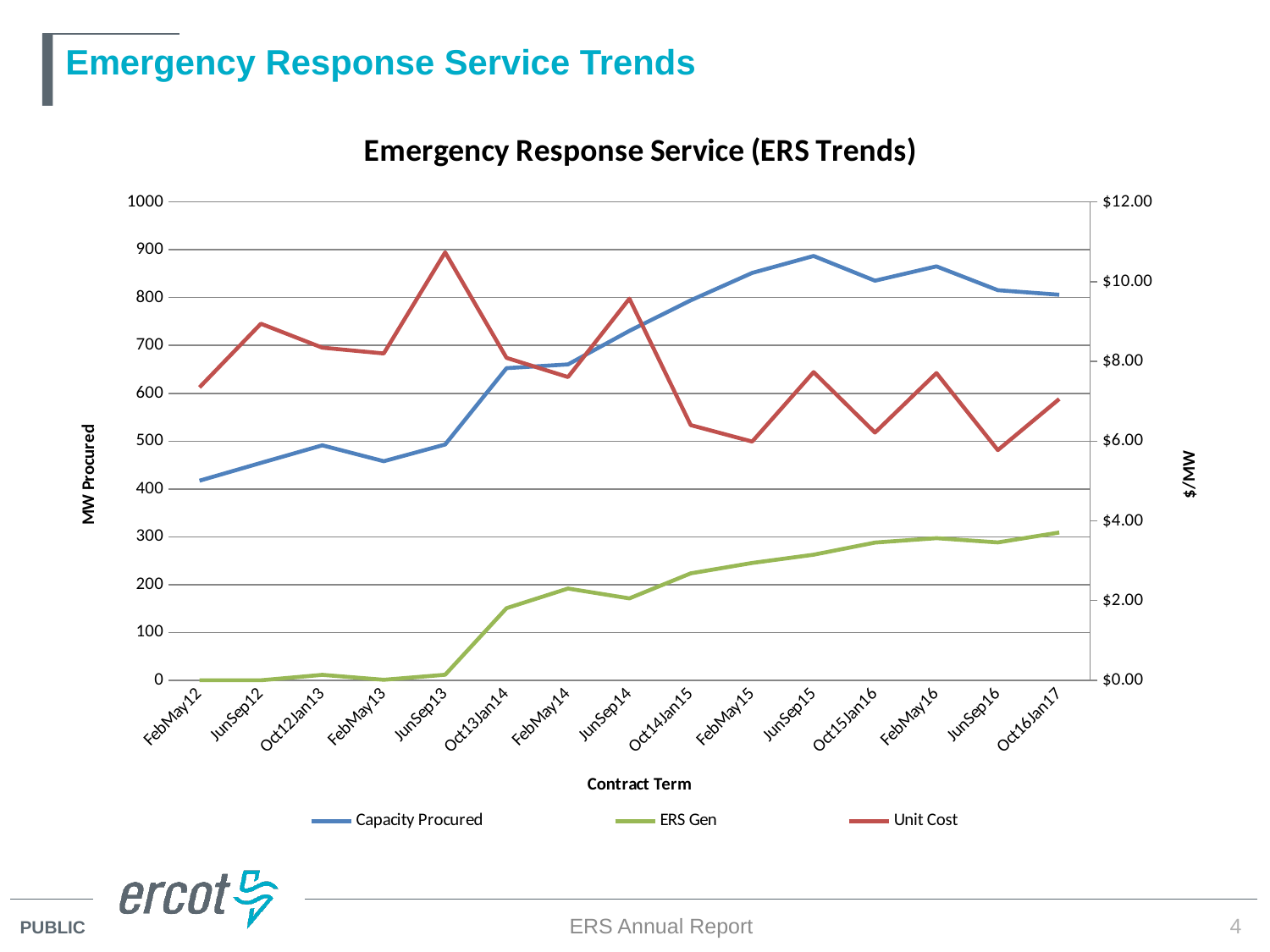
Which contract term has the highest Capacity Procured? JunSep15 Which contract term has the lowest Capacity Procured? FebMay12 Which is larger, the Capacity Procured for JunSep13 or for Oct13Jan14? Oct13Jan14 Does ERS Gen generally rise or fall from FebMay12 to Oct16Jan17? rise What kind of chart is shown on the slide? line chart Is the Capacity Procured for FebMay12 greater or less than 500? less How many series does the legend list? 3 Is the ERS Gen value for Oct16Jan17 greater or less than 200? greater Is the Unit Cost for JunSep13 greater or less than $10.00? greater Which contract term has the highest Unit Cost? JunSep13 What is the label of the right-hand vertical axis? $/MW How many contract terms are plotted along the x axis? 15